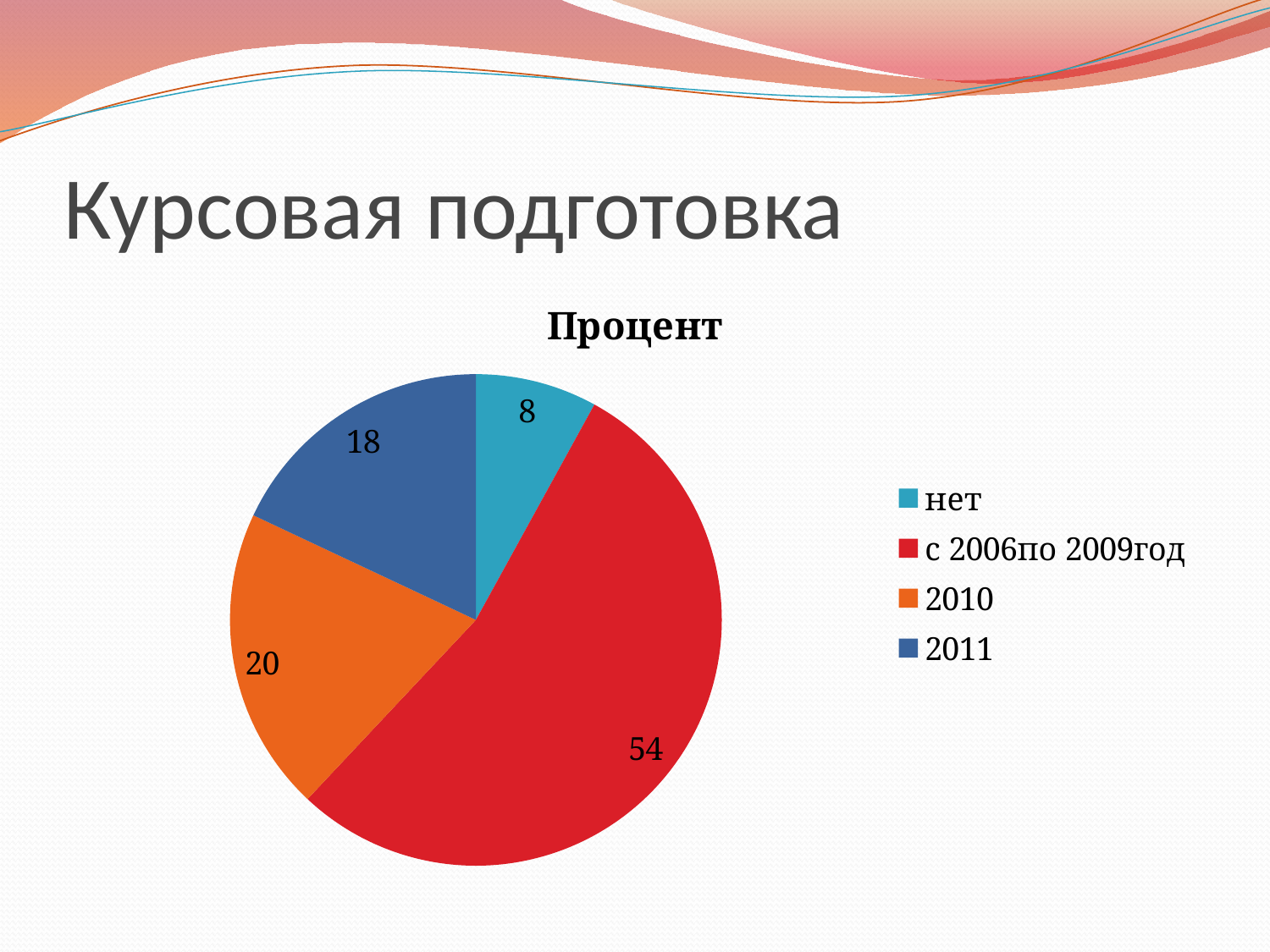
Which category has the largest slice? с 2006по 2009год Which category has the smallest slice? нет What is the difference between the values for "с 2006по 2009год" and "2010"? 34 What is the value for the "с 2006по 2009год" slice? 54 Which is larger, the value for "2010" or the value for "2011"? 2010 How many slices does the pie chart have? 4 What kind of chart is shown on the slide? pie chart What is the value for the "2010" slice? 20 What is the value for the "2011" slice? 18 What is the value for the "нет" slice? 8 What colour is the slice for "2011"? blue What is the title of the chart? Процент